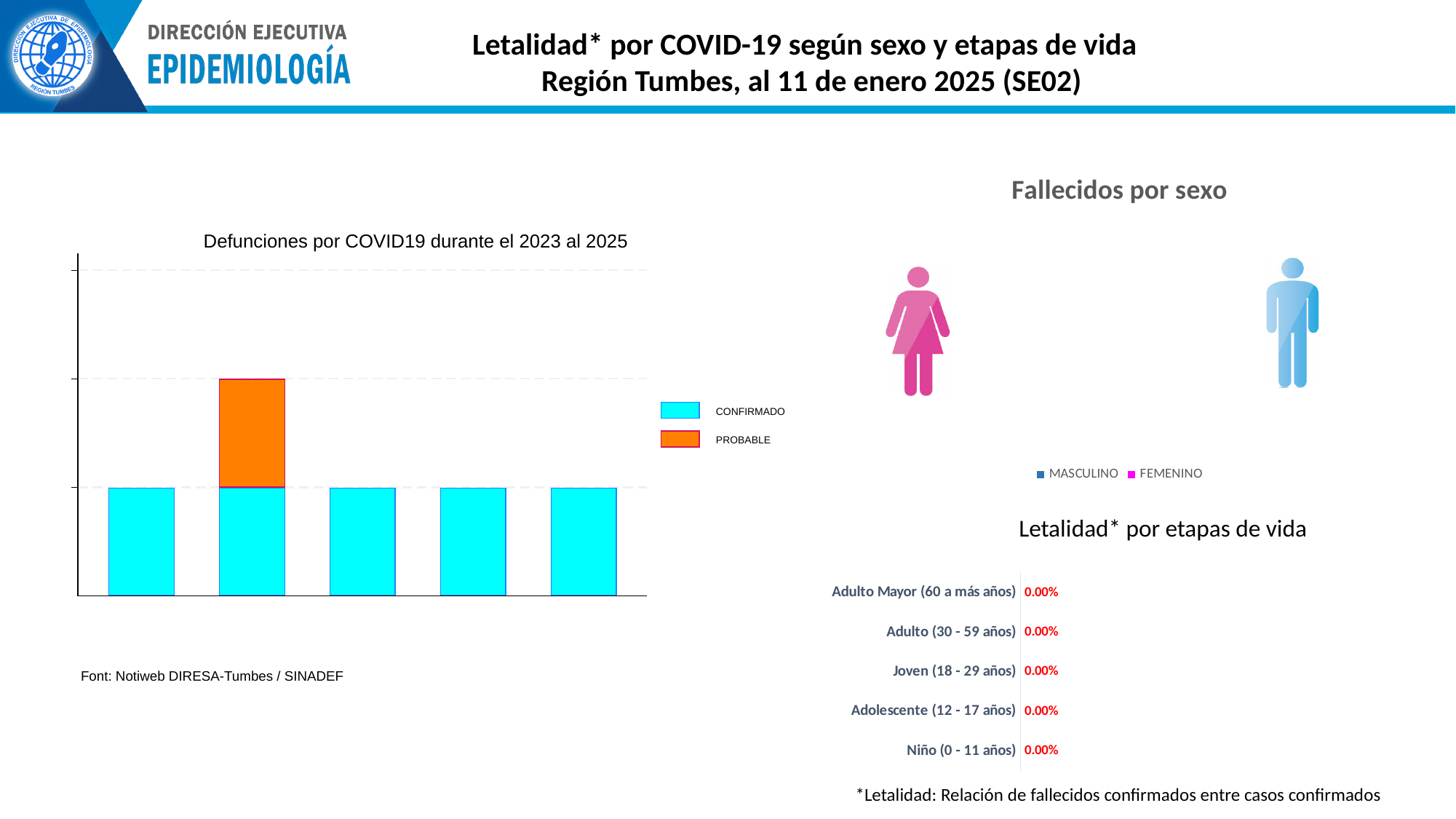
In the chart titled 'Defunciones por COVID19 durante el 2023 al 2025', how many series does the legend list? 2 In the chart titled 'Letalidad* por etapas de vida', what is the value for Niño (0 - 11 años)? 0.00% In the chart titled 'Defunciones por COVID19 durante el 2023 al 2025', how many bars are plotted? 5 In the chart titled 'Defunciones por COVID19 durante el 2023 al 2025', which bar is the tallest? The second bar from the left In the chart titled 'Defunciones por COVID19 durante el 2023 al 2025', what kind of chart is it? Bar chart In the chart titled 'Letalidad* por etapas de vida', what is the difference between the values for Adulto (30 - 59 años) and Adolescente (12 - 17 años)? 0.00% In the chart titled 'Letalidad* por etapas de vida', what is the value for Joven (18 - 29 años)? 0.00% In the chart titled 'Fallecidos por sexo', what are the two legend entries? MASCULINO and FEMENINO In the chart titled 'Letalidad* por etapas de vida', how many age-group categories are shown? 5 In the chart titled 'Defunciones por COVID19 durante el 2023 al 2025', which series is shown in orange? PROBABLE In the chart titled 'Fallecidos por sexo', how many series does the legend list? 2 In the chart titled 'Letalidad* por etapas de vida', what is the value for Adulto Mayor (60 a más años)? 0.00%